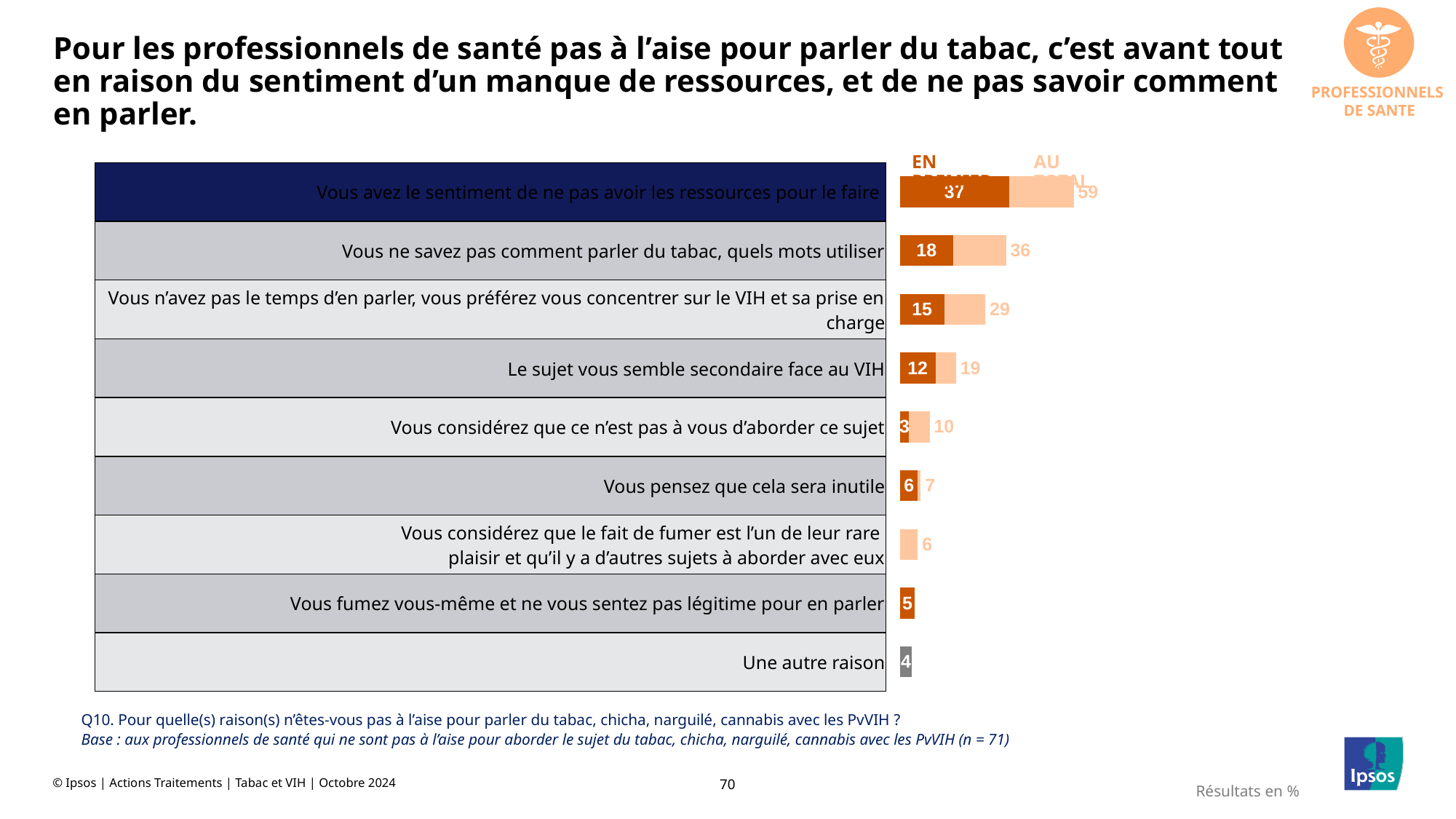
What is the light orange (total) value for "Vous ne savez pas comment parler du tabac, quels mots utiliser"? 36 Which has a larger light orange (total) value: "Le sujet vous semble secondaire face au VIH" or "Vous considérez que ce n'est pas à vous d'aborder ce sujet"? Le sujet vous semble secondaire face au VIH What is the value shown for "Une autre raison"? 4 Which reason has the highest light orange (total) value? Vous avez le sentiment de ne pas avoir les ressources pour le faire In what unit are the results expressed, according to the note at the bottom right of the slide? % How many reasons (categories) are listed in the chart? 9 What is the difference between the light orange (total) values for "Vous ne savez pas comment parler du tabac, quels mots utiliser" and "Vous n'avez pas le temps d'en parler, vous préférez vous concentrer sur le VIH et sa prise en charge"? 7 What is the dark orange value for "Le sujet vous semble secondaire face au VIH"? 12 What is the dark orange value for "Vous avez le sentiment de ne pas avoir les ressources pour le faire"? 37 What kind of chart is shown on the slide? bar chart What is the dark orange value for "Vous fumez vous-même et ne vous sentez pas légitime pour en parler"? 5 What is the light orange (total) value for "Vous avez le sentiment de ne pas avoir les ressources pour le faire"? 59